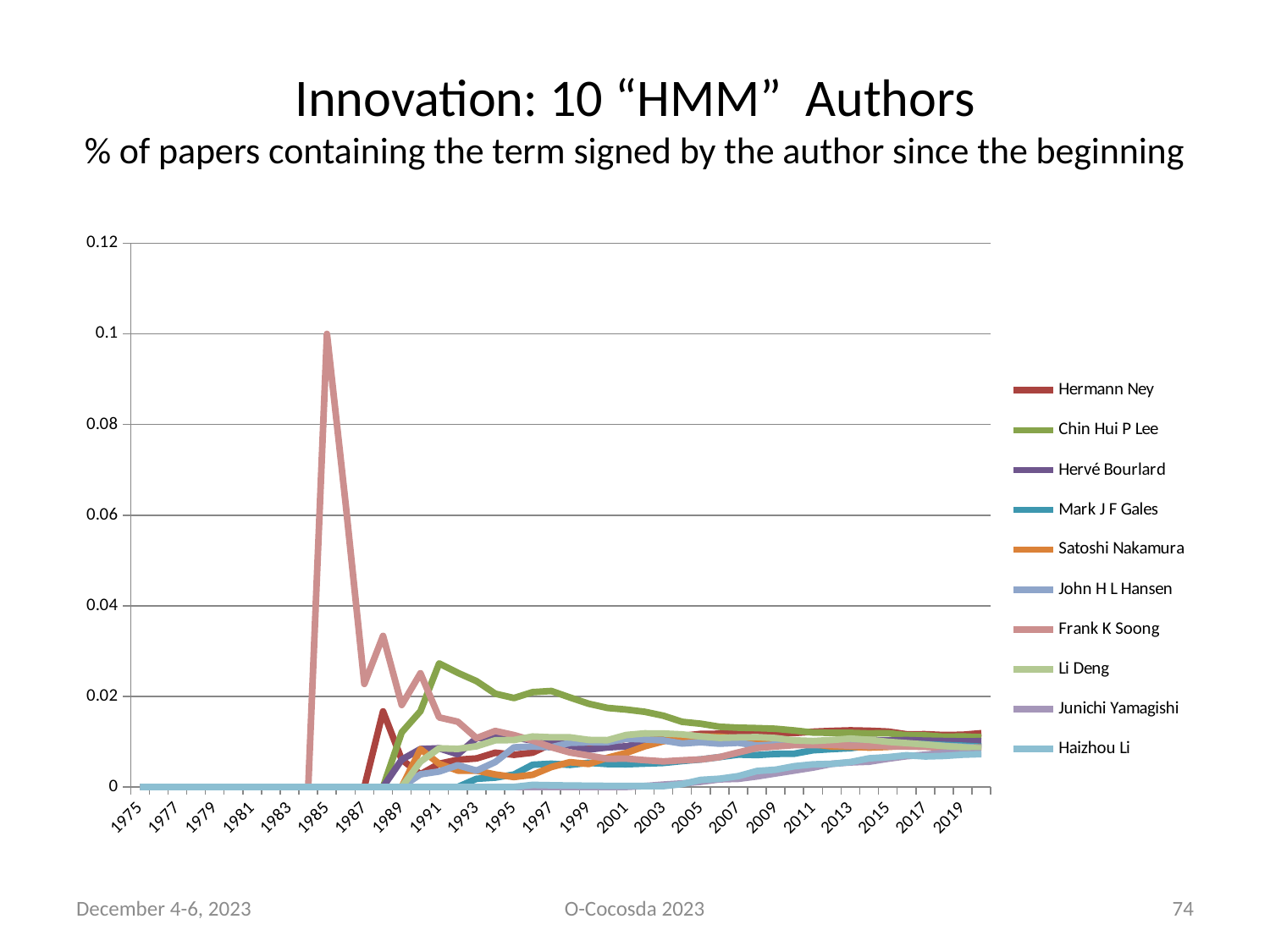
Is the value for Frank K Soong in 1987 greater or less than 0.04? less Is the value for Haizhou Li in 2005 greater or less than 0.02? less In 1995, which is larger: the value for Chin Hui P Lee or the value for Haizhou Li? Chin Hui P Lee What is the title of the slide containing the chart? Innovation: 10 "HMM" Authors What kind of chart is shown on the slide? line chart What is the first author listed in the legend? Hermann Ney Is the value for Frank K Soong in 1985 greater or less than 0.08? greater Which author's line reaches the highest value on the chart? Frank K Soong Does the line for Chin Hui P Lee rise or fall from 1991 to 2019? fall Does the line for Haizhou Li rise or fall from 2005 to 2019? rise How many series does the legend list? 10